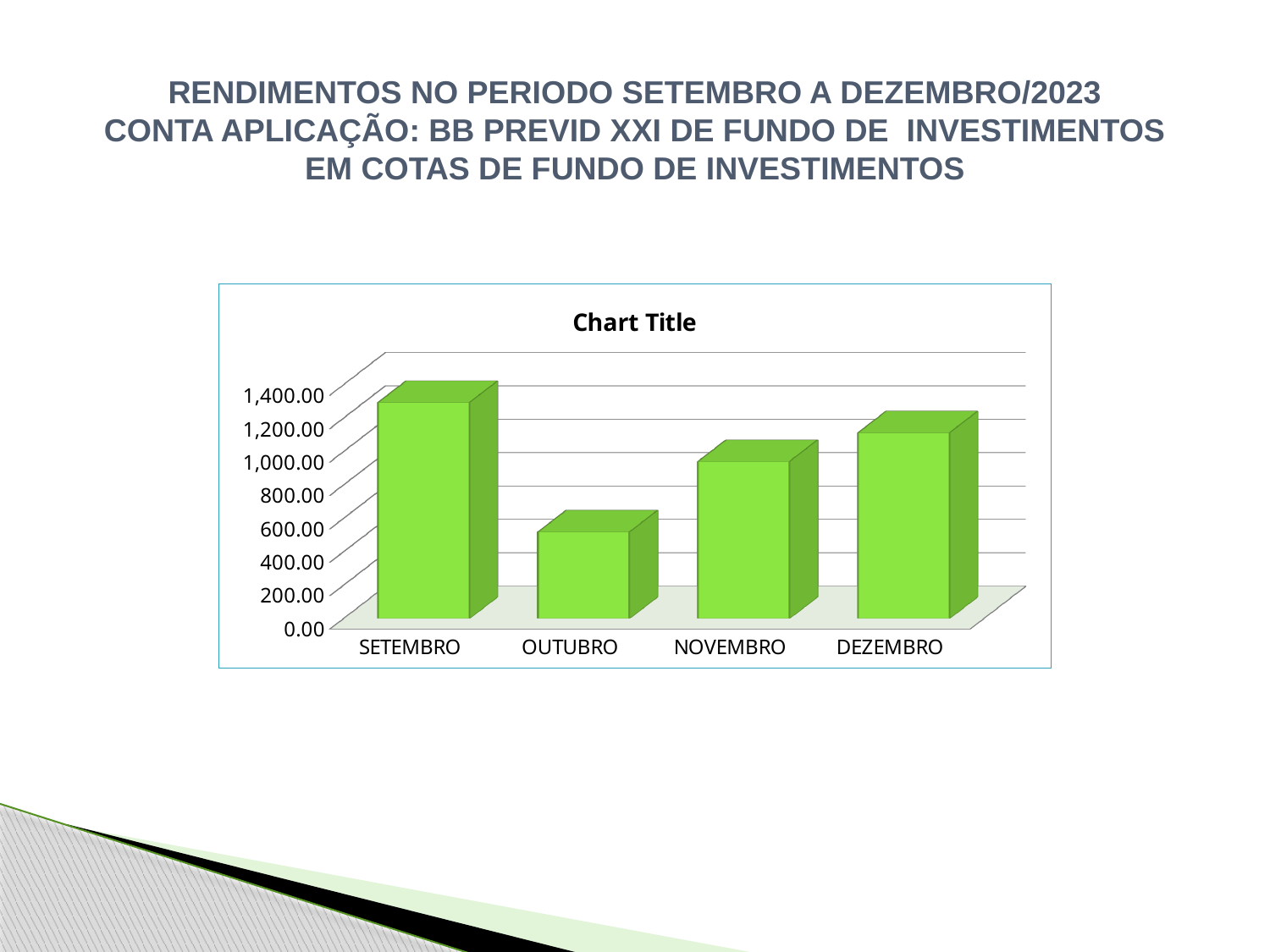
Is the value for DEZEMBRO greater or less than 1,000.00? greater How many categories are shown on the x axis of the chart? 4 What kind of chart is shown on the slide? bar chart Which month has the highest value in the chart? SETEMBRO Is the value for NOVEMBRO greater or less than 800.00? greater Which is larger, the value for OUTUBRO or the value for NOVEMBRO? NOVEMBRO Is the value for SETEMBRO greater or less than 1,000.00? greater What title is printed above the chart? Chart Title Which month has the lowest value in the chart? OUTUBRO Which is larger, the value for NOVEMBRO or the value for DEZEMBRO? DEZEMBRO Does the value rise or fall from SETEMBRO to OUTUBRO? fall